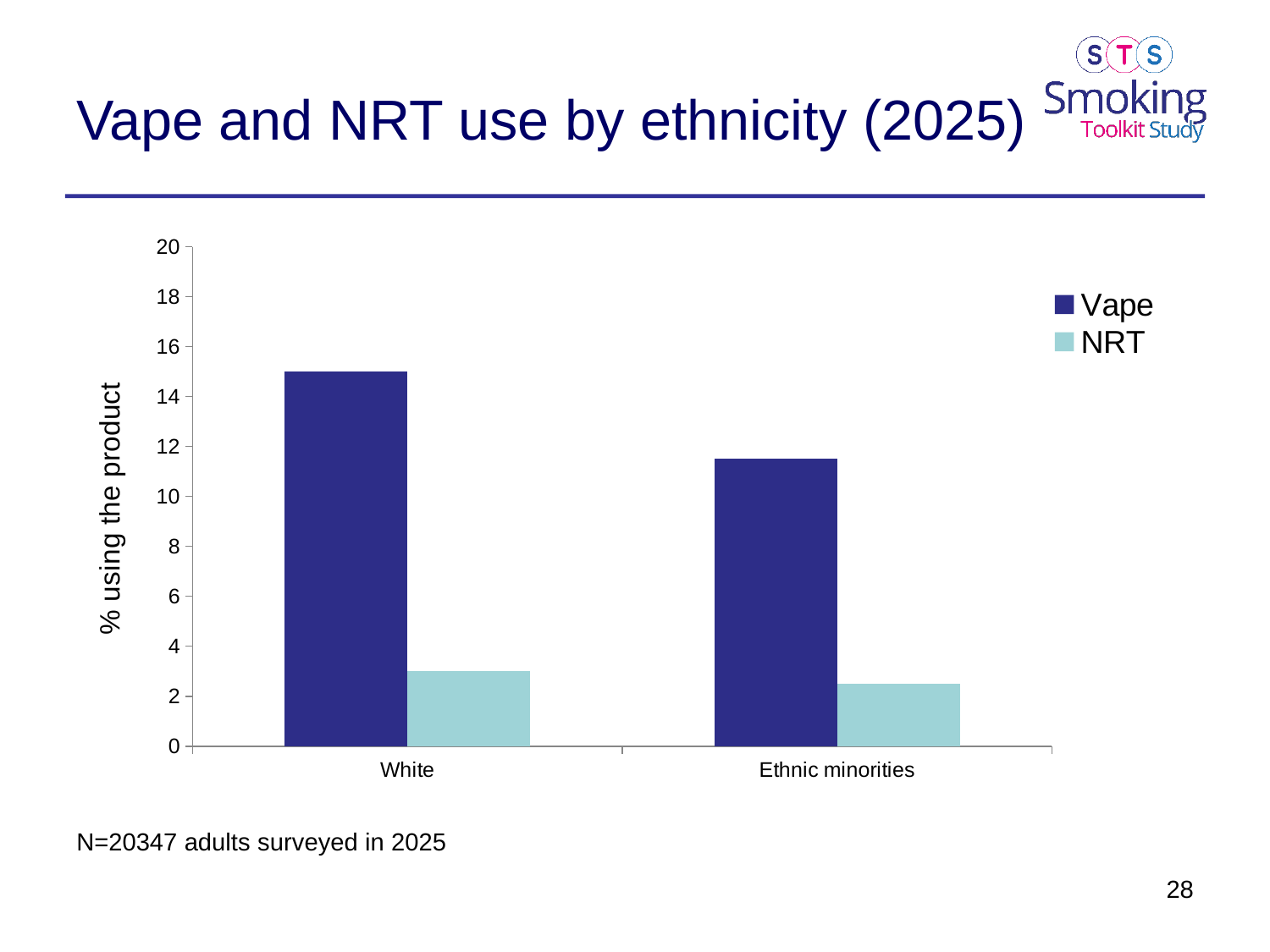
Is the Vape value for Ethnic minorities greater or less than 12? less Is the Vape value for Ethnic minorities greater or less than 10? greater Which category has the higher Vape value, White or Ethnic minorities? White Is the Vape value for White greater or less than 14? greater What kind of chart is shown on the slide? bar chart What is the label on the y axis? % using the product For Ethnic minorities, which is larger, the Vape value or the NRT value? Vape How many series does the legend list? 2 How many categories are shown on the x axis? 2